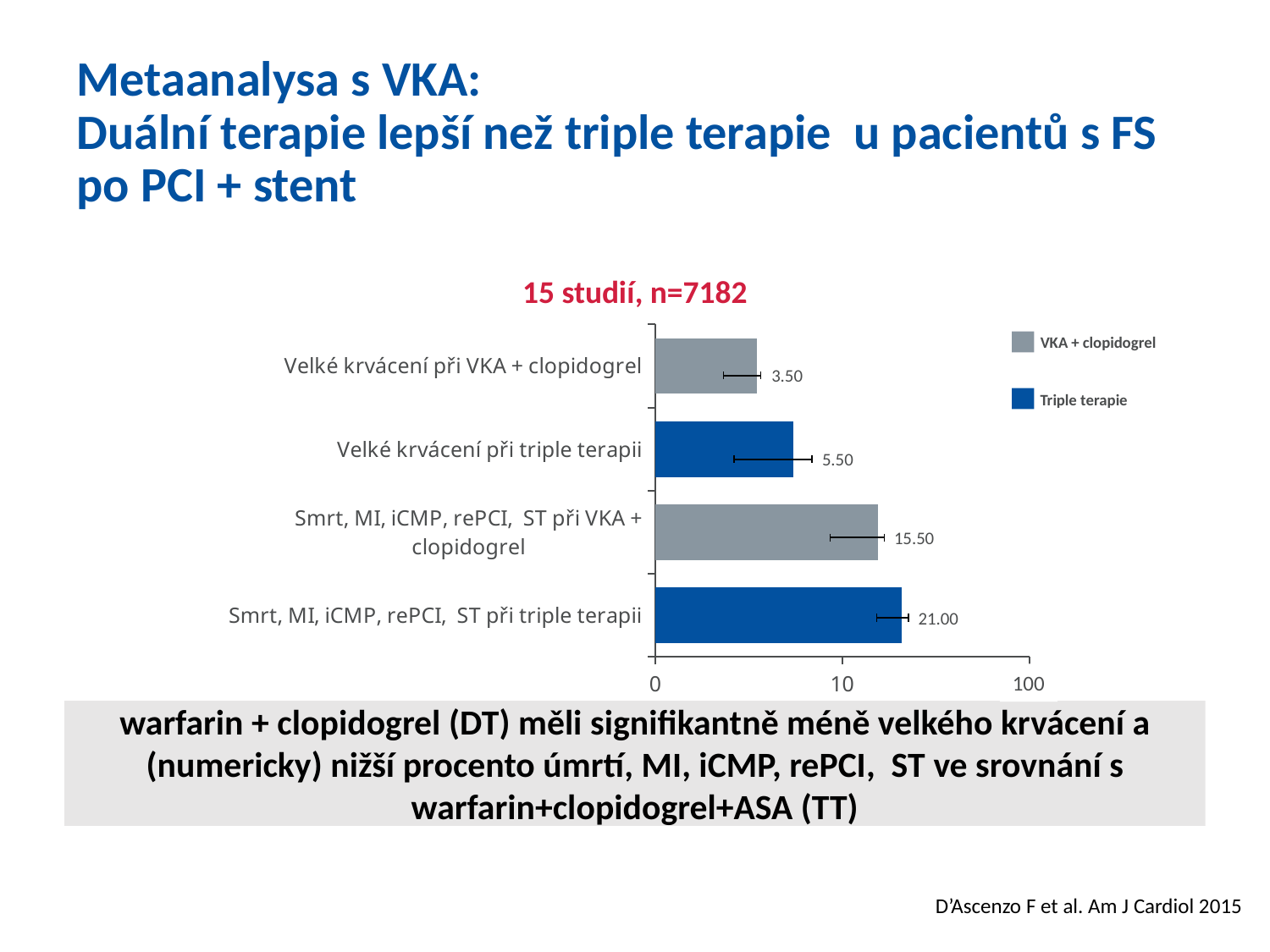
What kind of chart is shown on the slide? Bar chart What is the value for "Velké krvácení při triple terapii"? 5.50 How many series does the legend list? 2 Which category has the highest value? Smrt, MI, iCMP, rePCI, ST při triple terapii What is the difference between the values for "Velké krvácení při triple terapii" and "Velké krvácení při VKA + clopidogrel"? 2.00 What is the difference between the values for "Smrt, MI, iCMP, rePCI, ST při triple terapii" and "Smrt, MI, iCMP, rePCI, ST při VKA + clopidogrel"? 5.50 What is the value for "Smrt, MI, iCMP, rePCI, ST při triple terapii"? 21.00 What is the value for "Velké krvácení při VKA + clopidogrel"? 3.50 How many categories (bars) does the chart show? 4 What is the value for "Smrt, MI, iCMP, rePCI, ST při VKA + clopidogrel"? 15.50 Which is larger: the value for "Velké krvácení při triple terapii" or for "Velké krvácení při VKA + clopidogrel"? Velké krvácení při triple terapii Which category has the lowest value? Velké krvácení při VKA + clopidogrel